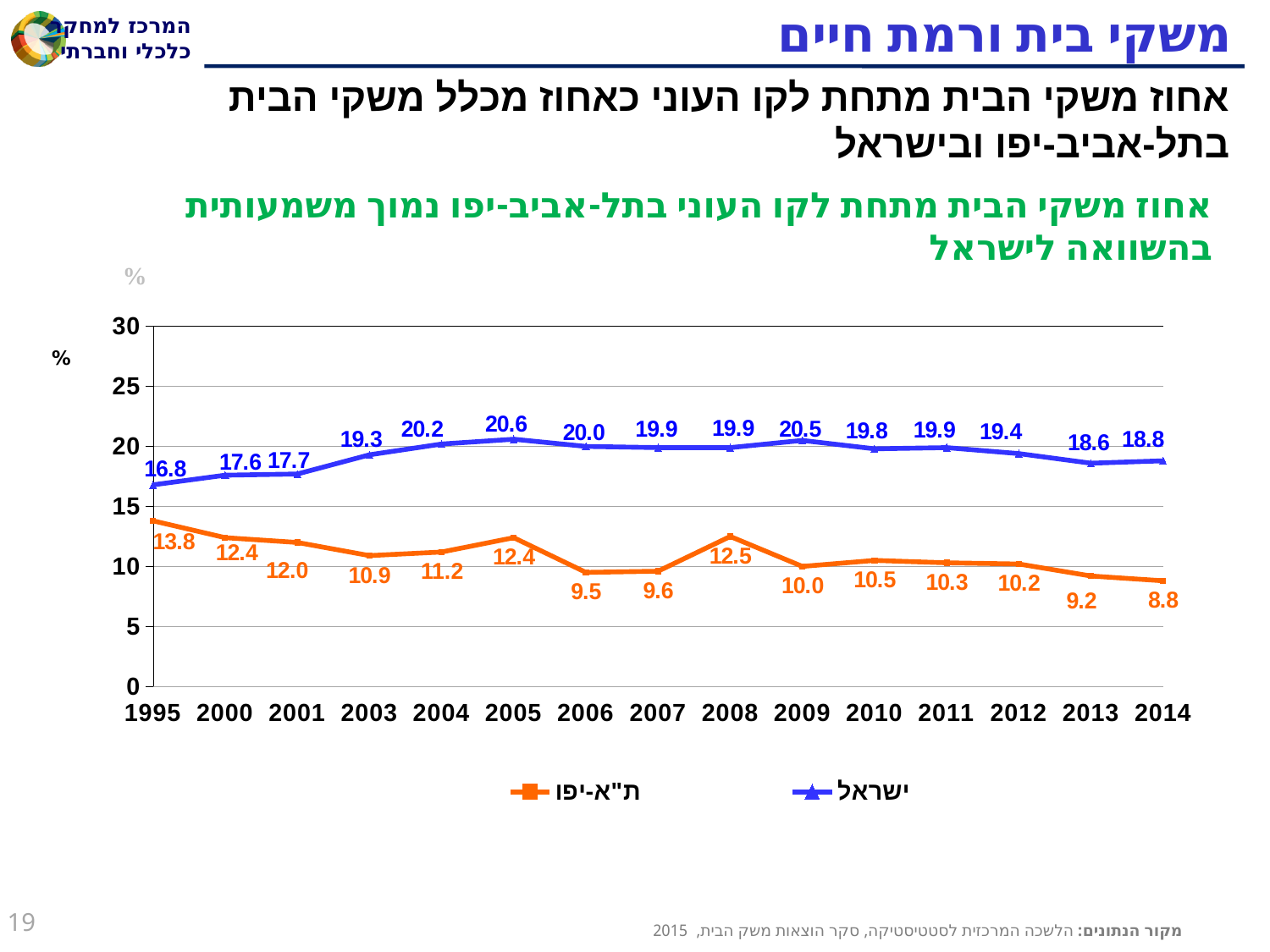
In which year is the ישראל series at its highest? 2005 What is the value for ת"א-יפו in 2008? 12.5 Which colour is used for the ת"א-יפו series? orange What type of chart is shown on the slide? line chart In which year is the ת"א-יפו series at its lowest? 2014 What is the value for ת"א-יפו in 2014? 8.8 How many series does the legend list? 2 What is the difference between the ישראל and ת"א-יפו values in 2014? 10.0 What is the value for ישראל in 2005? 20.6 Does the ת"א-יפו series generally rise or fall from 1995 to 2014? fall Which series has the larger value in 1995, ישראל or ת"א-יפו? ישראל How many years are plotted along the x axis? 15